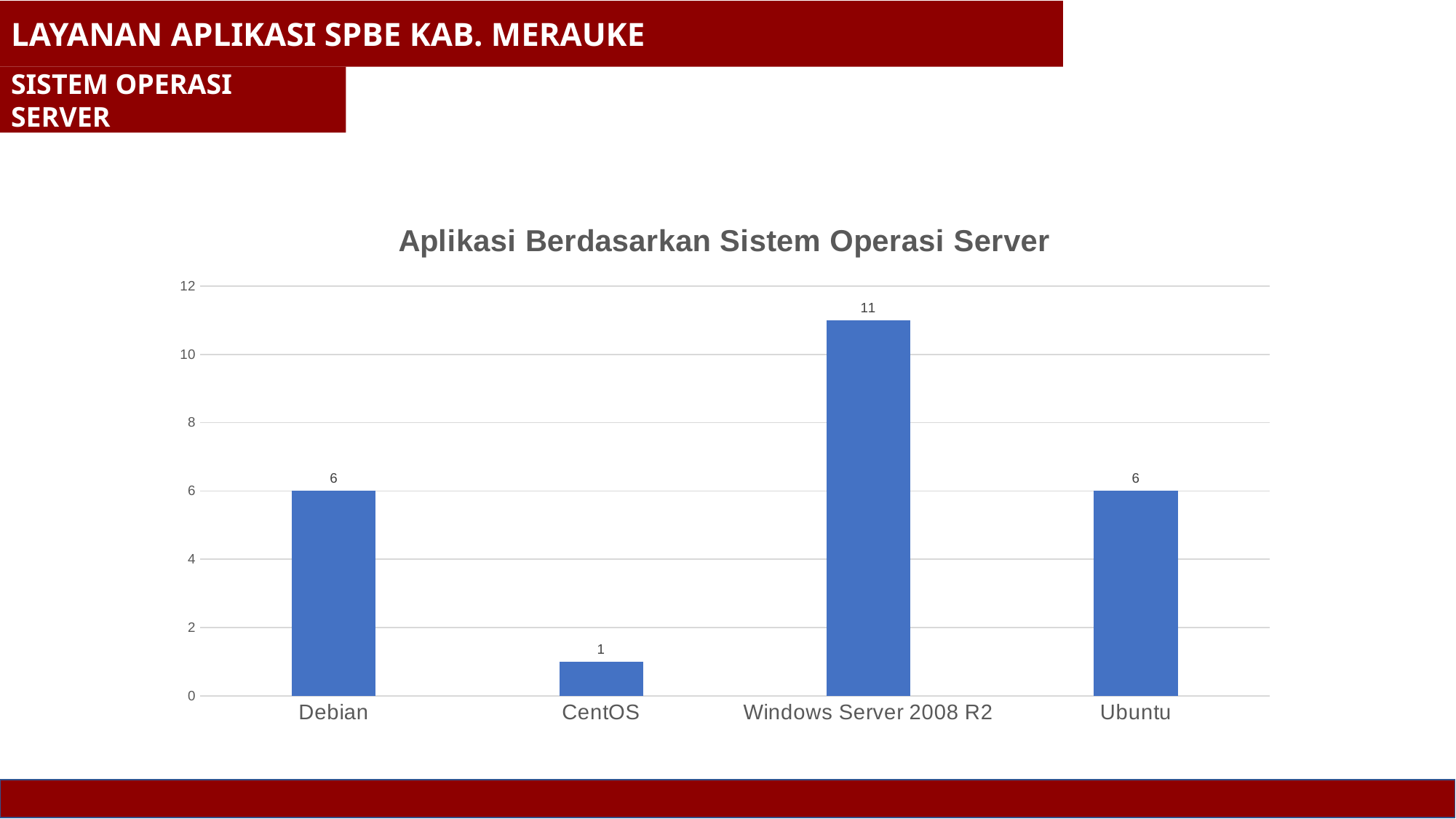
What is the value for CentOS? 1 What kind of chart is shown on the slide? bar chart What is the value for Debian? 6 Which category has the lowest value? CentOS Which category has the highest value? Windows Server 2008 R2 What is the difference between the values for Windows Server 2008 R2 and Ubuntu? 5 How many categories are shown on the x axis? 4 Which is larger, the value for Debian or the value for CentOS? Debian What is the value for Windows Server 2008 R2? 11 What is the difference between the values for Debian and CentOS? 5 Is the value for Windows Server 2008 R2 greater or less than 10? greater What is the title of the chart? Aplikasi Berdasarkan Sistem Operasi Server